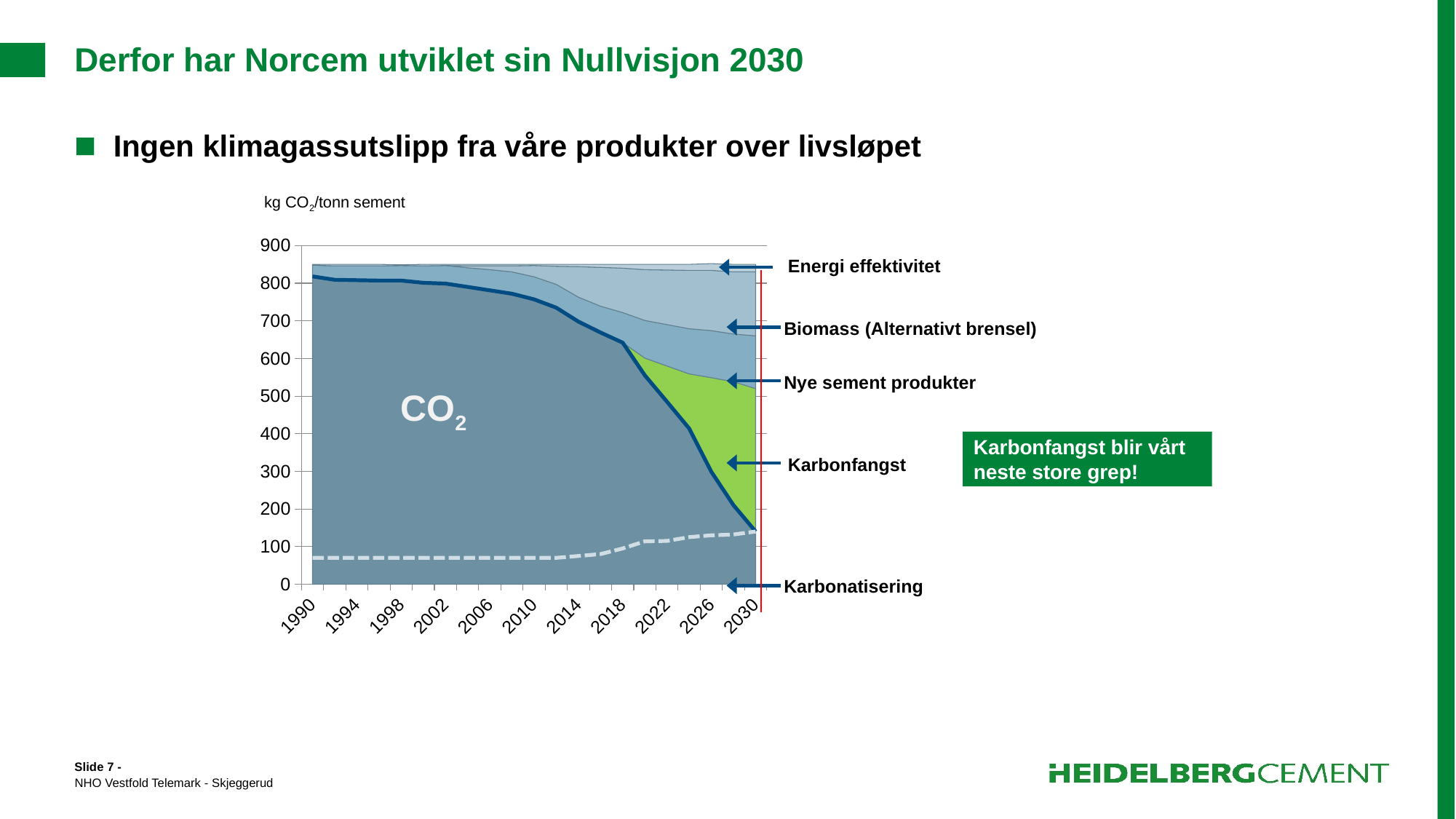
What is the highest value shown on the y axis of the chart? 900 What is the last year shown on the x axis of the chart? 2030 What unit is shown above the y axis of the chart? kg CO2/tonn sement Is the CO2 value in 2018 greater or less than 500? greater What kind of chart is shown on the slide? Area chart Is the CO2 value in 2030 greater or less than 300? less How many year labels are shown along the x axis of the chart? 11 Does the dashed Karbonatisering line rise or fall from 1990 to 2030? Rise Does the CO2 line (dark blue) rise or fall from 1990 to 2030? Fall Which measure is shown as the green area in the chart? Karbonfangst Is the CO2 value in 1990 greater or less than 700? greater What is the first year shown on the x axis of the chart? 1990